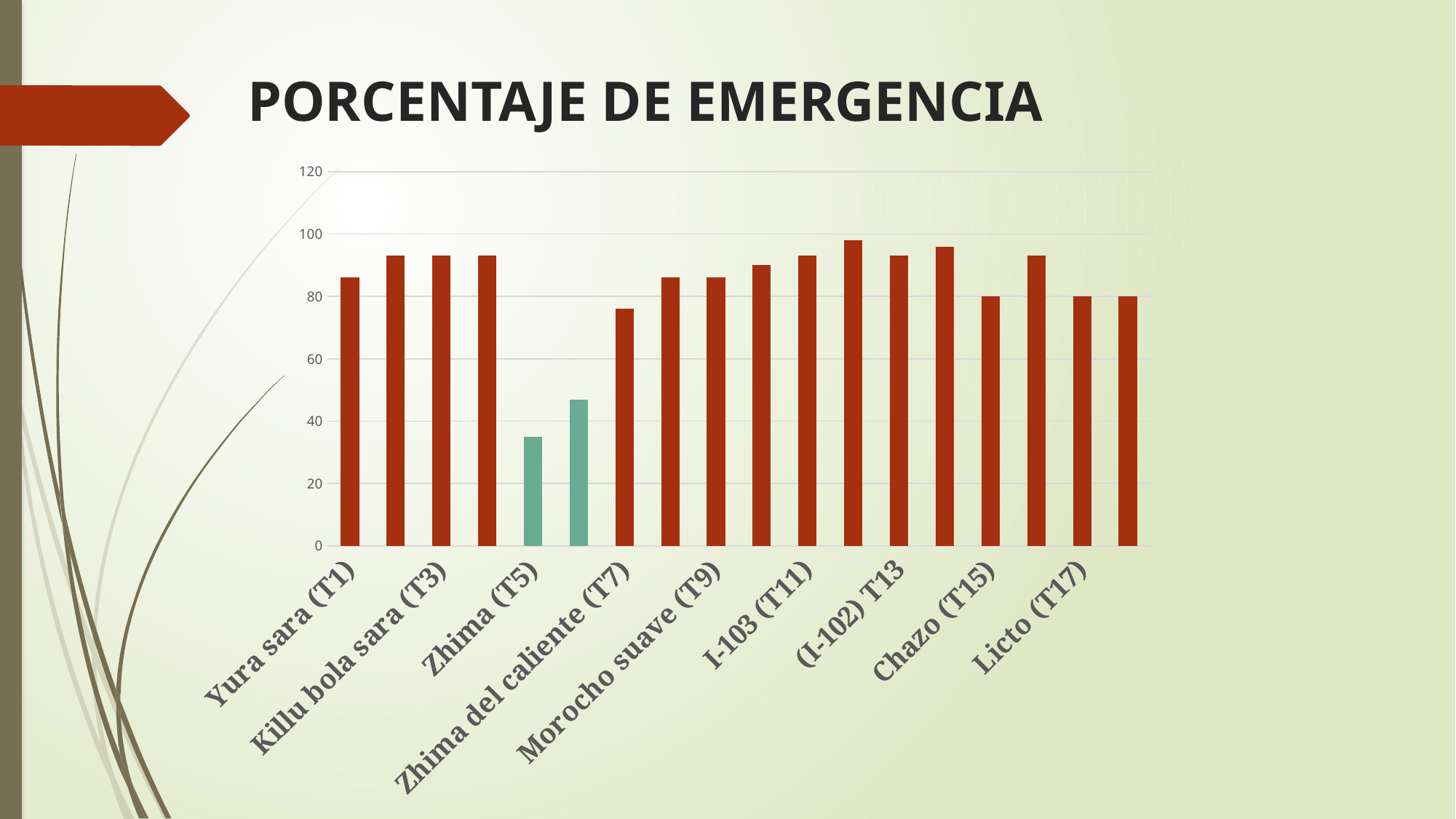
What kind of chart is shown on the slide? bar chart Which is larger, the value for Killu bola sara (T3) or the value for Zhima del caliente (T7)? Killu bola sara (T3) Which is larger, the value for Zhima (T5) or the value for Morocho suave (T9)? Morocho suave (T9) Which labeled category has the lowest bar? Zhima (T5) How many bars are plotted in the chart? 18 Is the value for Zhima del caliente (T7) greater or less than 80? less Is the value for Yura sara (T1) greater or less than 80? greater Is the value for Chazo (T15) greater or less than 100? less What is the title of the chart? PORCENTAJE DE EMERGENCIA What colour is the bar for Zhima (T5)? green